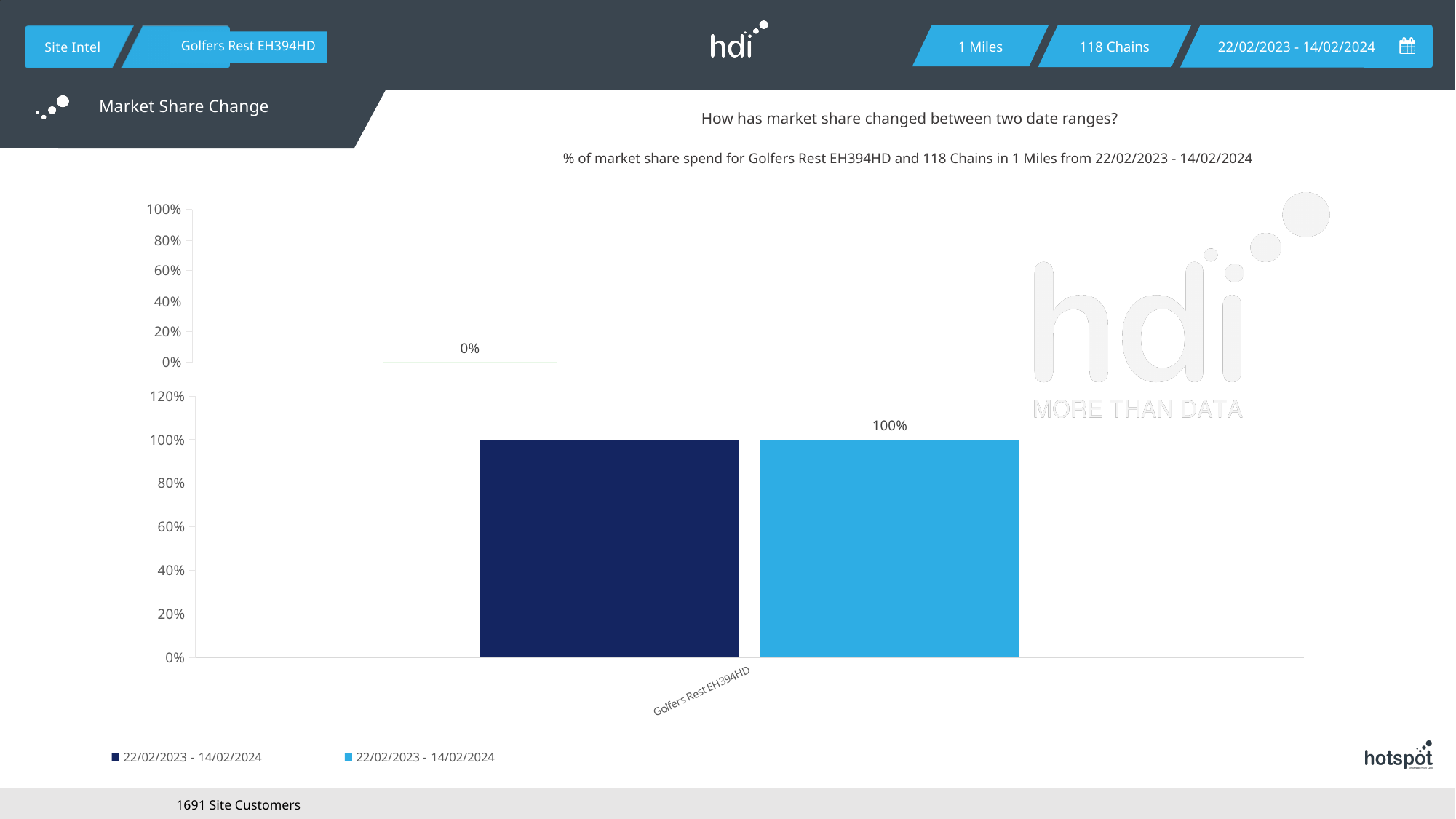
In the lower chart, is the value of the light blue bar greater or less than 80%? greater What kind of chart is the lower chart on the slide? bar chart What is the highest tick shown on the y axis of the lower chart? 120% In the lower chart, what is the difference between the light blue bar and the dark navy bar for Golfers Rest EH394HD? 0% In the upper chart, what value is printed as the data label? 0% What category label appears on the x axis of the lower chart? Golfers Rest EH394HD How many series does the legend at the bottom of the slide list? 2 In the lower chart, what value is printed above the light blue bar for Golfers Rest EH394HD? 100% In the upper chart, is the plotted value greater or less than 20%? less In the lower chart, what value does the dark navy bar for Golfers Rest EH394HD reach on the y axis? 100% What date range is shown for both legend entries at the bottom of the slide? 22/02/2023 - 14/02/2024 In the lower chart, how many categories are labelled on the x axis? 1